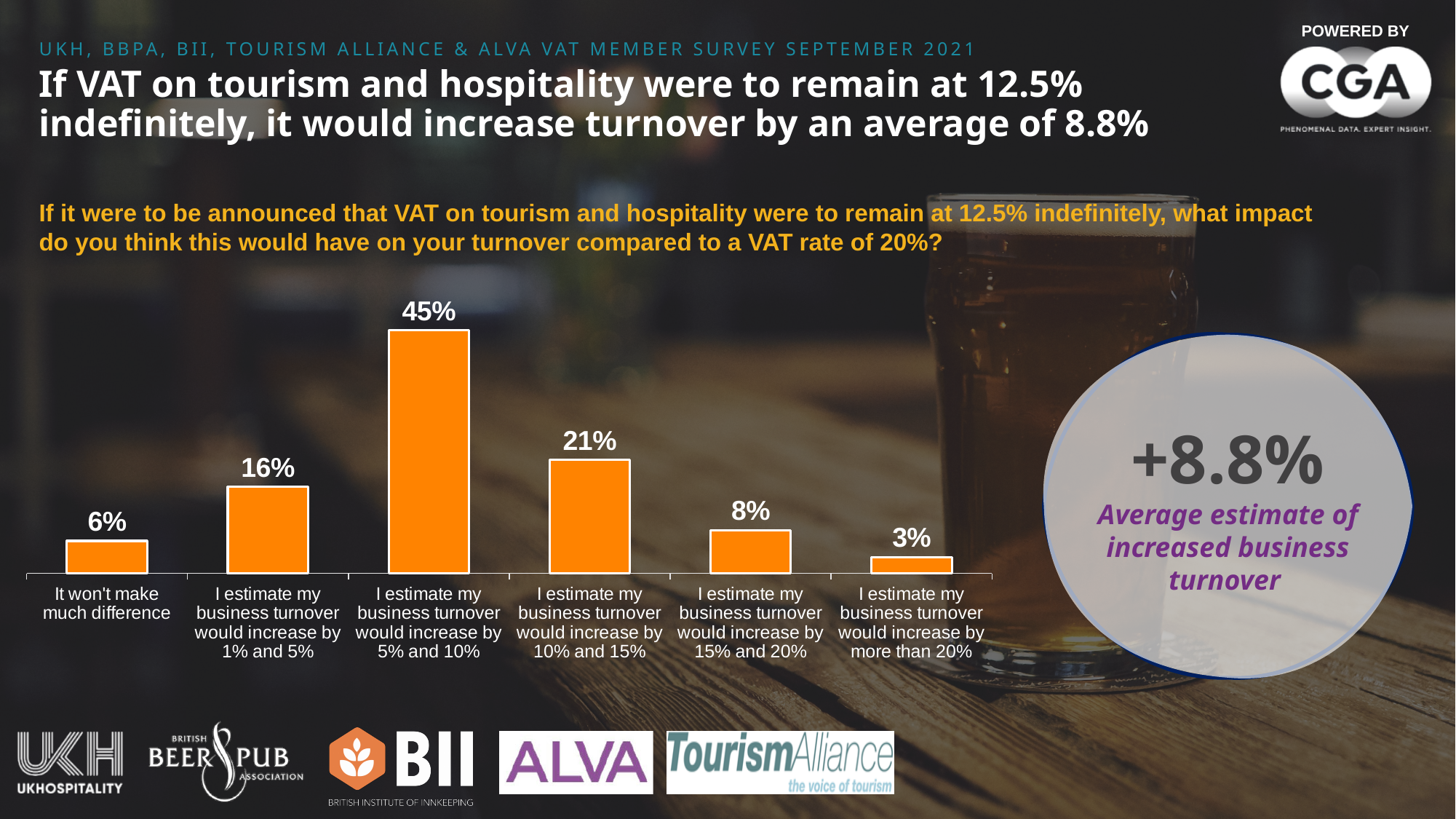
What colour are the bars in the chart? Orange What percentage of respondents said it won't make much difference? 6% What percentage of respondents estimate their business turnover would increase by between 15% and 20%? 8% What percentage of respondents estimate their business turnover would increase by between 5% and 10%? 45% How many response categories are shown in the chart? 6 Which response category has the highest percentage of respondents? I estimate my business turnover would increase by 5% and 10% What is the average estimate of increased business turnover shown in the circle on the slide? +8.8% Which response category has the lowest percentage of respondents? I estimate my business turnover would increase by more than 20% What type of chart is used on this slide? Bar chart What percentage of respondents estimate their business turnover would increase by more than 20%? 3% What is the difference in percentage points between the 5% and 10% increase category and the 10% and 15% increase category? 24 Which has a larger share of respondents: the 1% and 5% increase category or the 15% and 20% increase category? I estimate my business turnover would increase by 1% and 5%